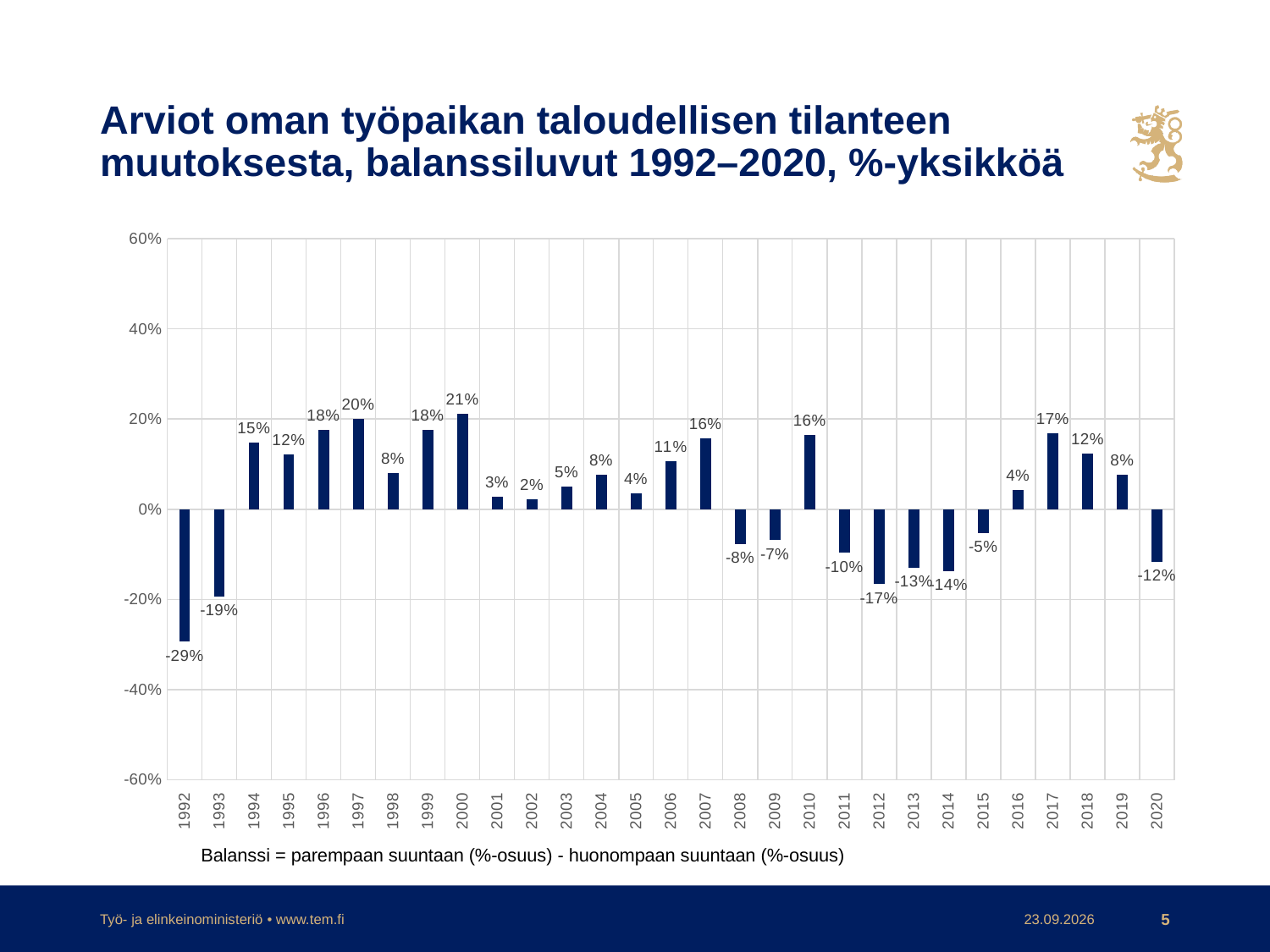
What is the value for 2000? 21% Which is larger, the value for 2007 or the value for 2006? 2007 What kind of chart is shown on the slide? Bar chart What is the value for 2012? -17% What is the value for 1992? -29% Is the value for 1993 greater or less than -20%? greater Which year has the lowest value? 1992 Do the values rise or fall from 2017 to 2020? Fall What is the difference between the values for 2017 and 2018? 5% Which year has the highest value? 2000 What is the value for 2020? -12% How many years are shown on the x axis? 29